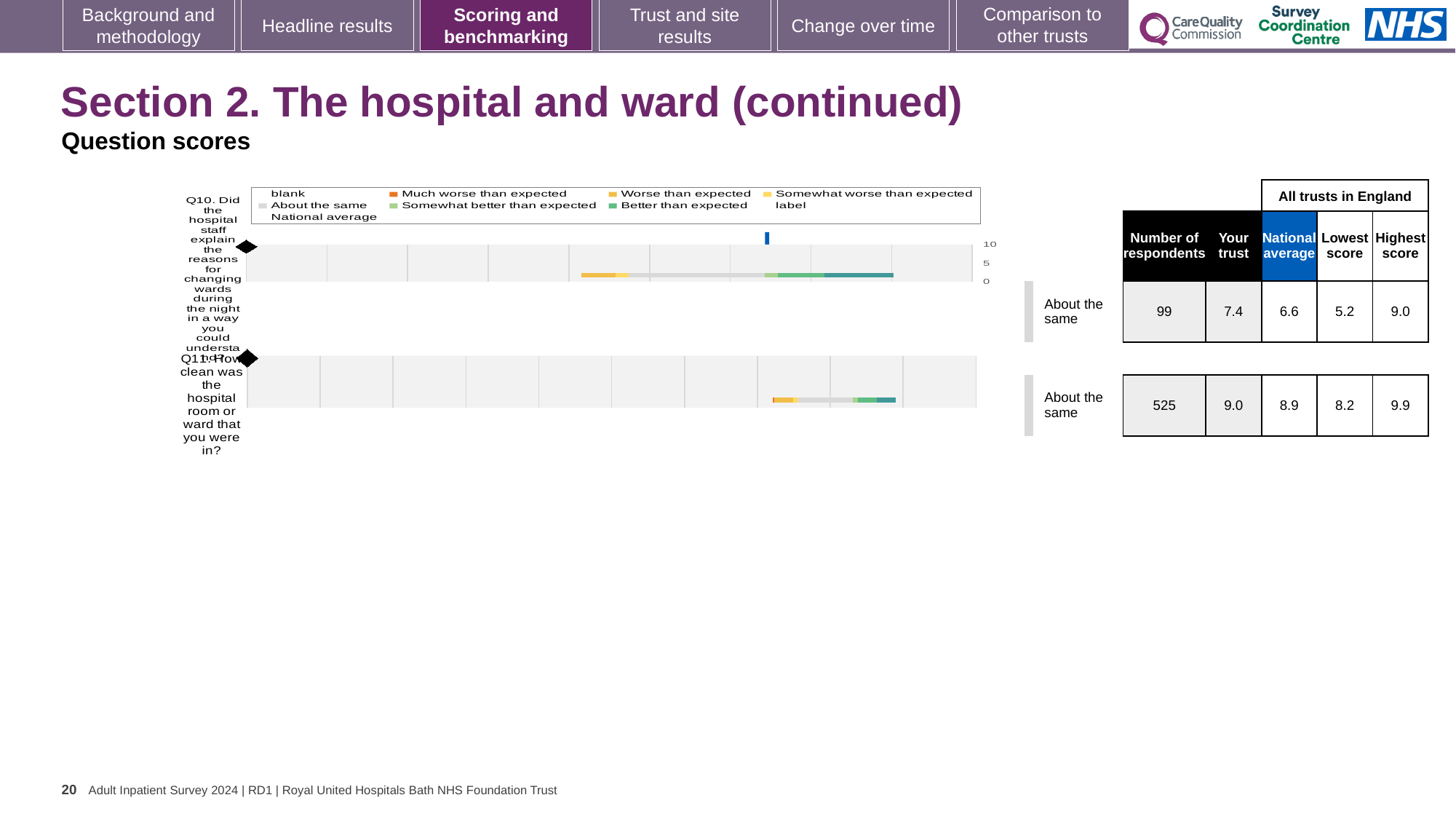
What is the highest score among all trusts in England for Q11? 9.9 What is the lowest score among all trusts in England for Q10? 5.2 What is the 'Your trust' score for Q10 (explaining reasons for changing wards during the night)? 7.4 What benchmark category is shown for Q10 next to the chart? About the same For Q11, which is larger: the 'Your trust' score or the national average? Your trust How many survey questions are plotted on the chart? 2 What is the national average score for Q10? 6.6 What kind of chart is used to show the question scores for Q10 and Q11? Bar chart By how much does the 'Your trust' score for Q11 exceed the national average? 0.1 What is the difference between the highest score and the lowest score for Q10? 3.8 Which question has the higher 'Your trust' score, Q10 or Q11? Q11 How many respondents answered Q11 (how clean was the hospital room or ward)? 525